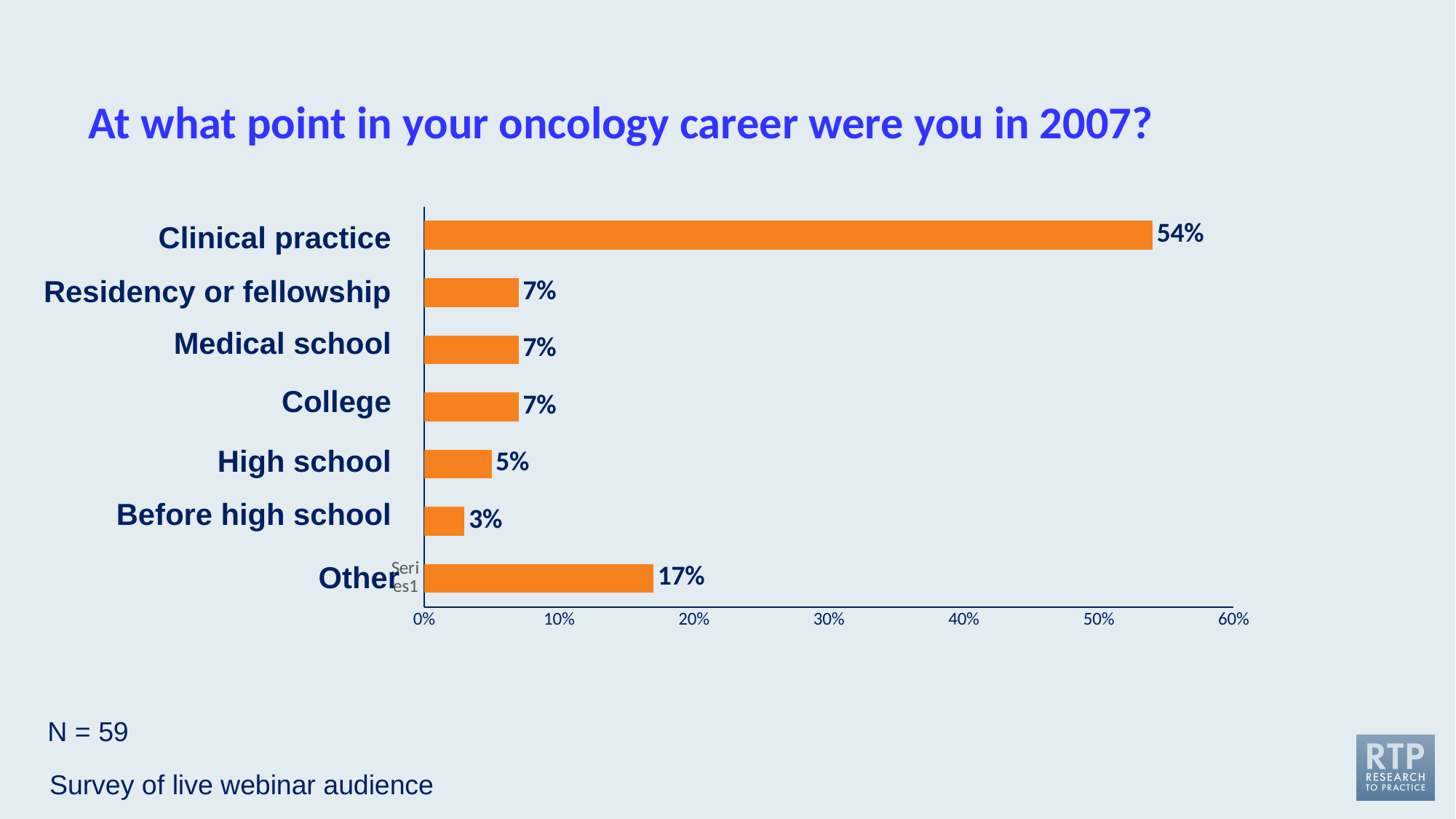
What is the difference between the values for Clinical practice and Other? 37% What is the difference between the values for High school and Before high school? 2% Is the value for Clinical practice greater or less than 50%? greater What kind of chart is shown on the slide? Bar chart What is the value for Before high school? 3% How many categories are shown in the chart? 7 Which category has the lowest value? Before high school Which category has the highest value? Clinical practice What is the value for Other? 17% What percentage of respondents were in clinical practice in 2007? 54% Which is larger, the value for Other or the value for Medical school? Other What is the value for High school? 5%